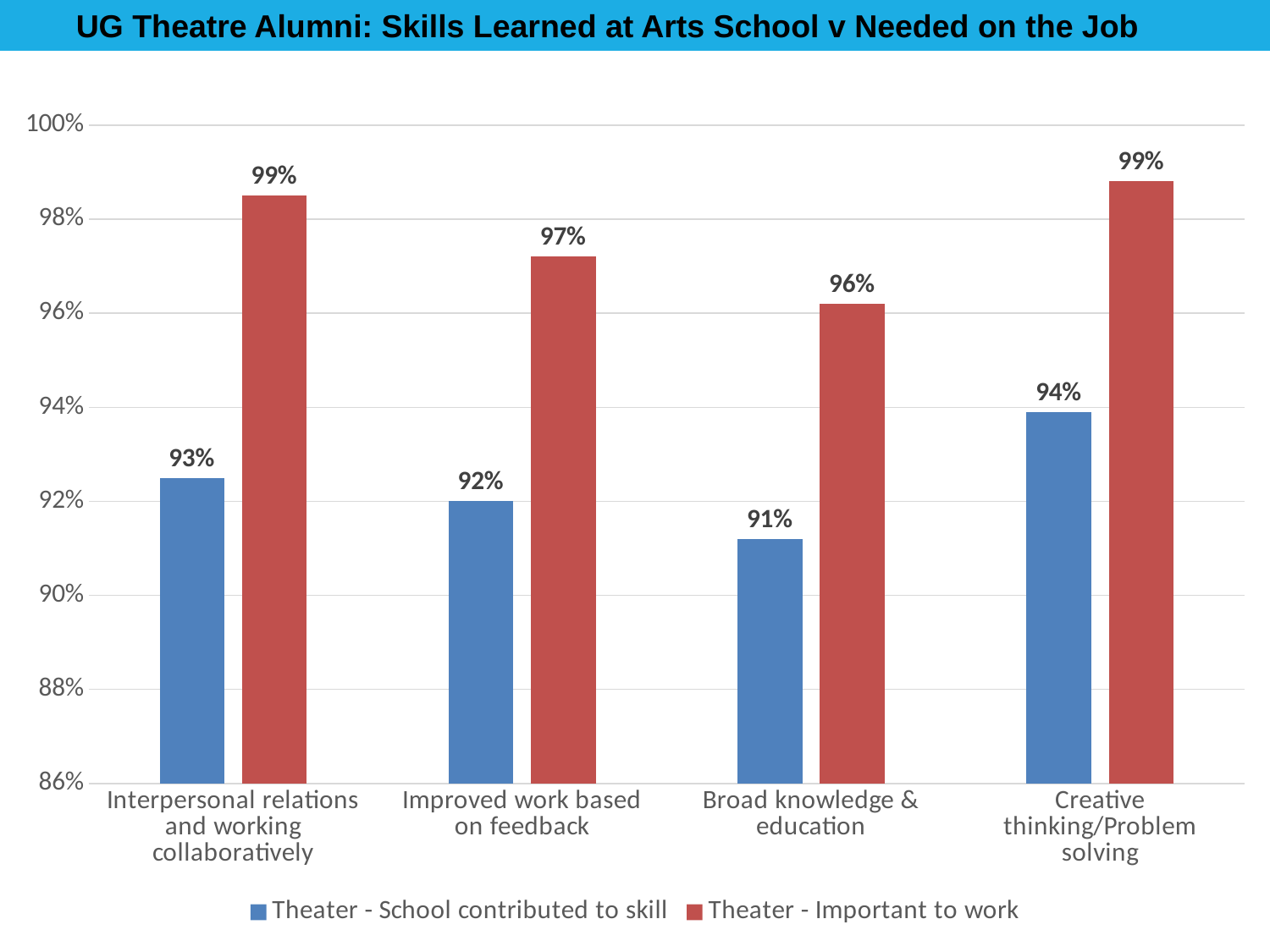
Which category has the highest value for 'Theater - School contributed to skill'? Creative thinking/Problem solving What kind of chart is shown on the slide? Bar chart What is the value for 'Theater - Important to work' for Broad knowledge & education? 96% For Creative thinking/Problem solving, which is larger: 'Theater - School contributed to skill' or 'Theater - Important to work'? Theater - Important to work What colour are the bars for 'Theater - Important to work'? Red Is the value for 'Theater - School contributed to skill' for Improved work based on feedback greater or less than 94%? less Which category has the lowest value for 'Theater - Important to work'? Broad knowledge & education What is the value for 'Theater - Important to work' for Improved work based on feedback? 97% How many series does the legend list? 2 How many skill categories are shown on the x axis? 4 What is the value for 'Theater - School contributed to skill' for Broad knowledge & education? 91% What is the difference between 'Theater - Important to work' and 'Theater - School contributed to skill' for Interpersonal relations and working collaboratively? 6 percentage points